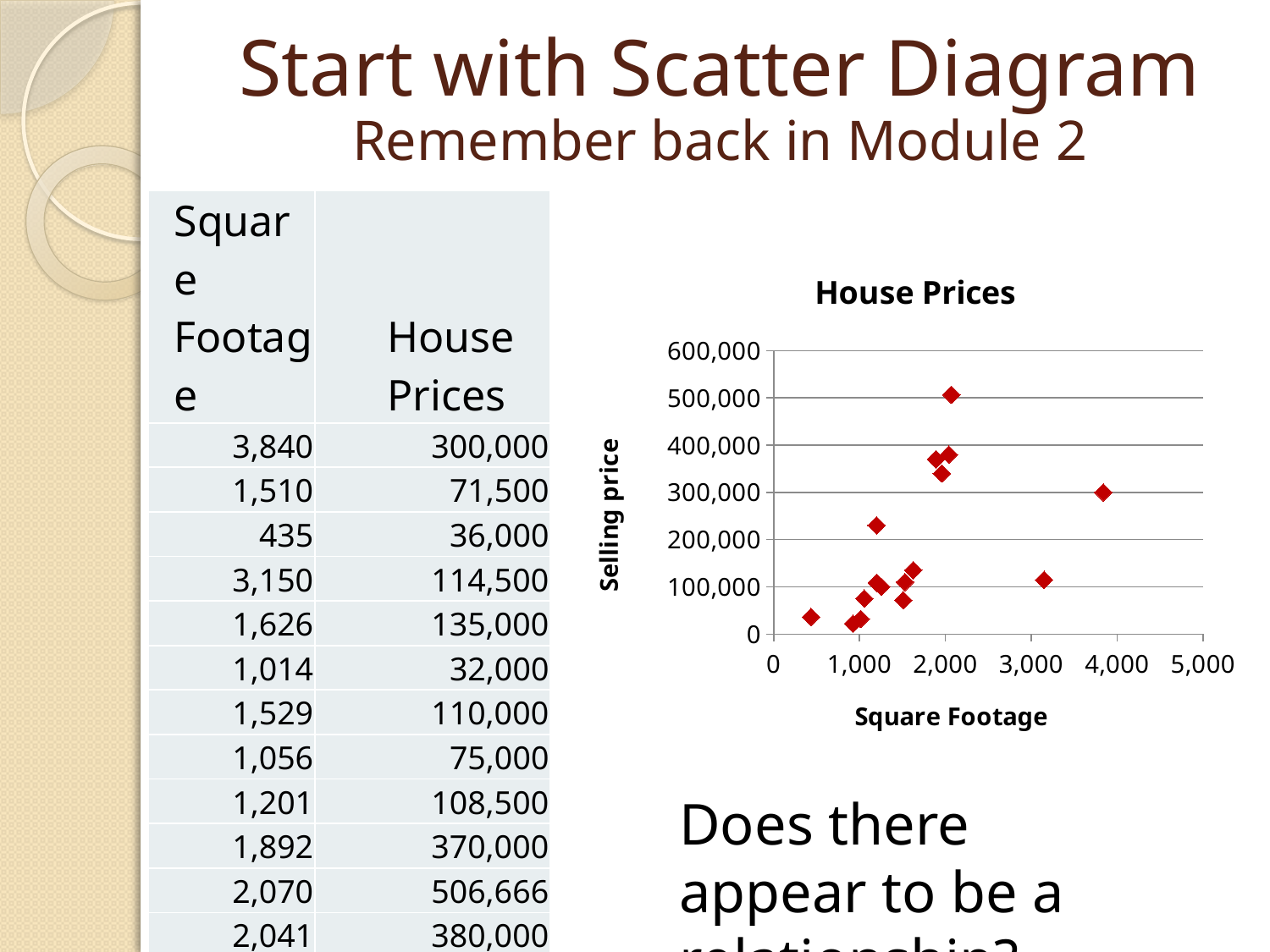
Is the highest selling price plotted on the chart greater or less than 400,000? greater What is the title of the chart? House Prices According to the table on the slide, what is the house price for the 3,840 square foot house plotted on the chart? 300,000 Which point has the higher selling price: the one at about 2,070 square feet or the one at about 3,840 square feet? the one at about 2,070 square feet Which point has the higher selling price: the one at about 3,840 square feet or the one at about 3,150 square feet? the one at about 3,840 square feet What kind of chart is shown on the slide? scatter chart Is the selling price of the point at about 3,150 square feet greater or less than 200,000? less According to the table on the slide, what is the house price for the 2,070 square foot house plotted on the chart? 506,666 Is the selling price of the point with the largest square footage (about 3,840) greater or less than 200,000? greater Roughly what square footage does the point with the highest selling price have: closer to 2,000 or closer to 4,000? closer to 2,000 What is the label on the vertical axis of the chart? Selling price